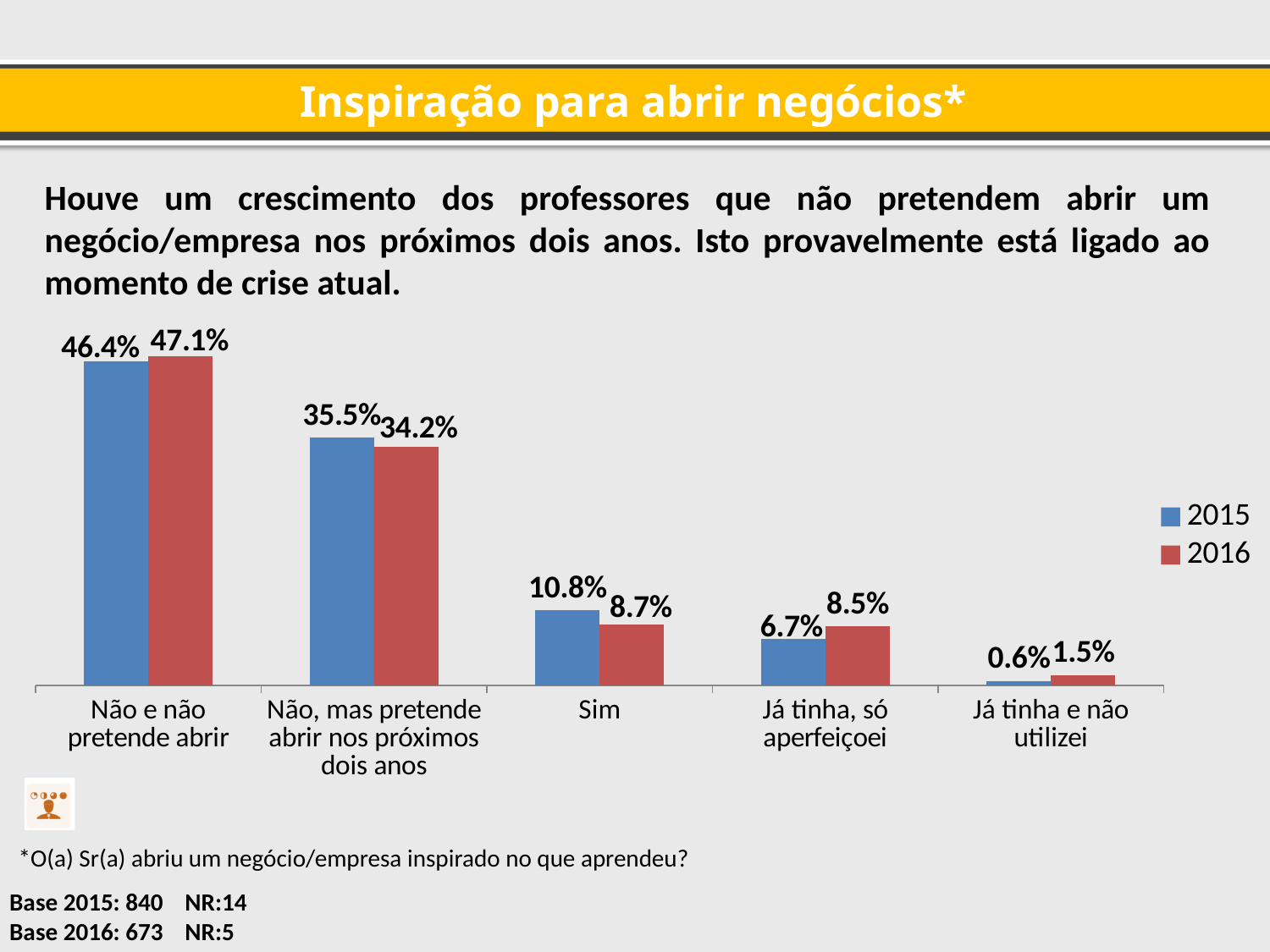
Which category has the highest 2015 value? Não e não pretende abrir What is the difference between the 2016 values for "Sim" and "Já tinha, só aperfeiçoei"? 0.2% For "Já tinha, só aperfeiçoei", which year has the larger value, 2015 or 2016? 2016 What is the 2015 value for "Sim"? 10.8% How many series does the legend list? 2 Which colour represents the 2016 series in the legend? Red What kind of chart is shown on the slide? Bar chart What is the 2015 value for "Já tinha e não utilizei"? 0.6% What is the 2016 value for "Não e não pretende abrir"? 47.1% Which category has the lowest 2016 value? Já tinha e não utilizei How many categories are shown on the x axis? 5 What is the difference between the 2015 and 2016 values for "Não, mas pretende abrir nos próximos dois anos"? 1.3%